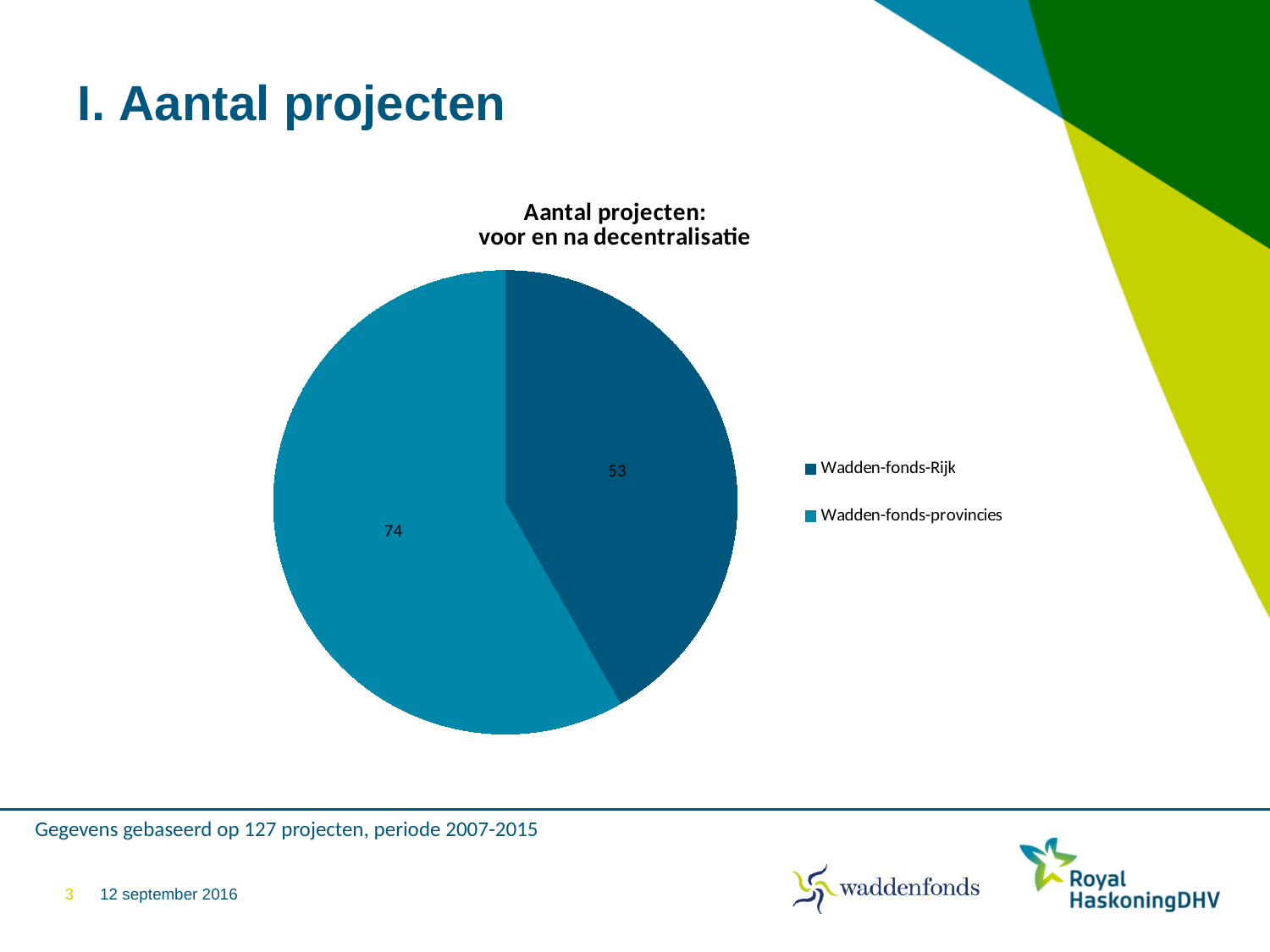
What is the difference between the values for Wadden-fonds-provincies and Wadden-fonds-Rijk? 21 What is the value for Wadden-fonds-Rijk? 53 Which is larger, the value for Wadden-fonds-Rijk or the value for Wadden-fonds-provincies? Wadden-fonds-provincies How many entries does the legend list? 2 Which legend entry is shown in the darker blue colour? Wadden-fonds-Rijk What is the total of the two slices in the pie chart? 127 Which category has the smallest slice? Wadden-fonds-Rijk Which category has the largest slice? Wadden-fonds-provincies How many slices does the pie chart have? 2 What kind of chart is shown on the slide? pie chart What is the value for Wadden-fonds-provincies? 74 What is the title of the chart? Aantal projecten: voor en na decentralisatie